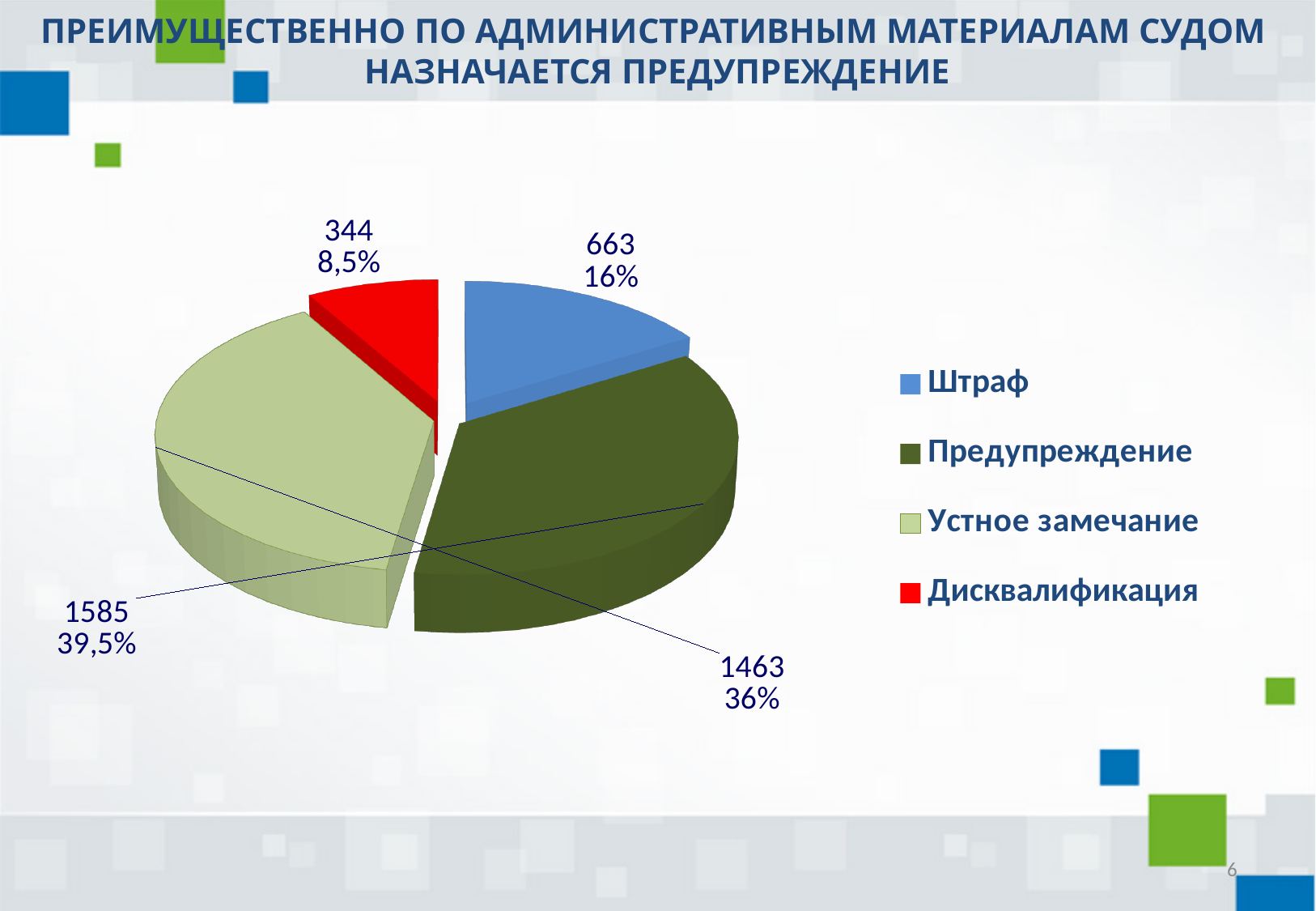
What is the value for Дисквалификация? 344 What percentage share does Дисквалификация have? 8,5% What is the value for Штраф? 663 What is the value for Предупреждение? 1463 What percentage share does Устное замечание have? 39,5% What is the difference between the values for Штраф and Дисквалификация? 319 How many entries does the legend list? 4 Which category has the smallest slice? Дисквалификация What percentage share does Штраф have? 16% How many slices does the pie chart have? 4 What type of chart is shown on the slide? Pie chart Which category has the largest slice? Устное замечание